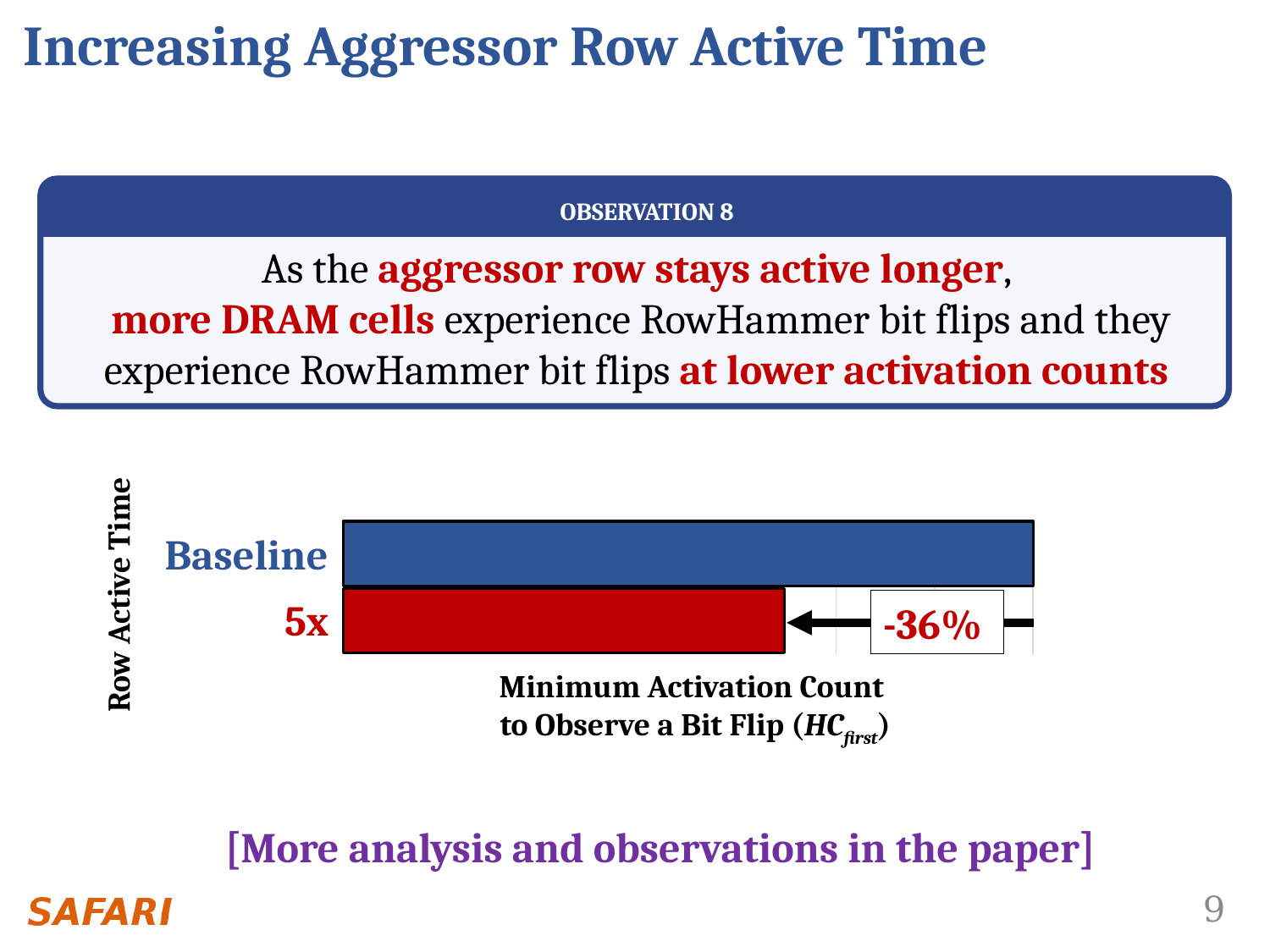
What is the label on the horizontal axis of the chart? Minimum Activation Count to Observe a Bit Flip (HCfirst) What kind of chart is shown on the slide? bar chart Which category has the shortest bar in the chart? 5x How many categories (bars) does the chart show? 2 Which category has the longest bar in the chart? Baseline What is the label on the vertical axis of the chart? Row Active Time By what percentage does the 5x bar differ from the Baseline bar, according to the label on the chart? -36% Which bar is longer, Baseline or 5x? Baseline As row active time increases from Baseline to 5x, does the minimum activation count to observe a bit flip rise or fall? fall